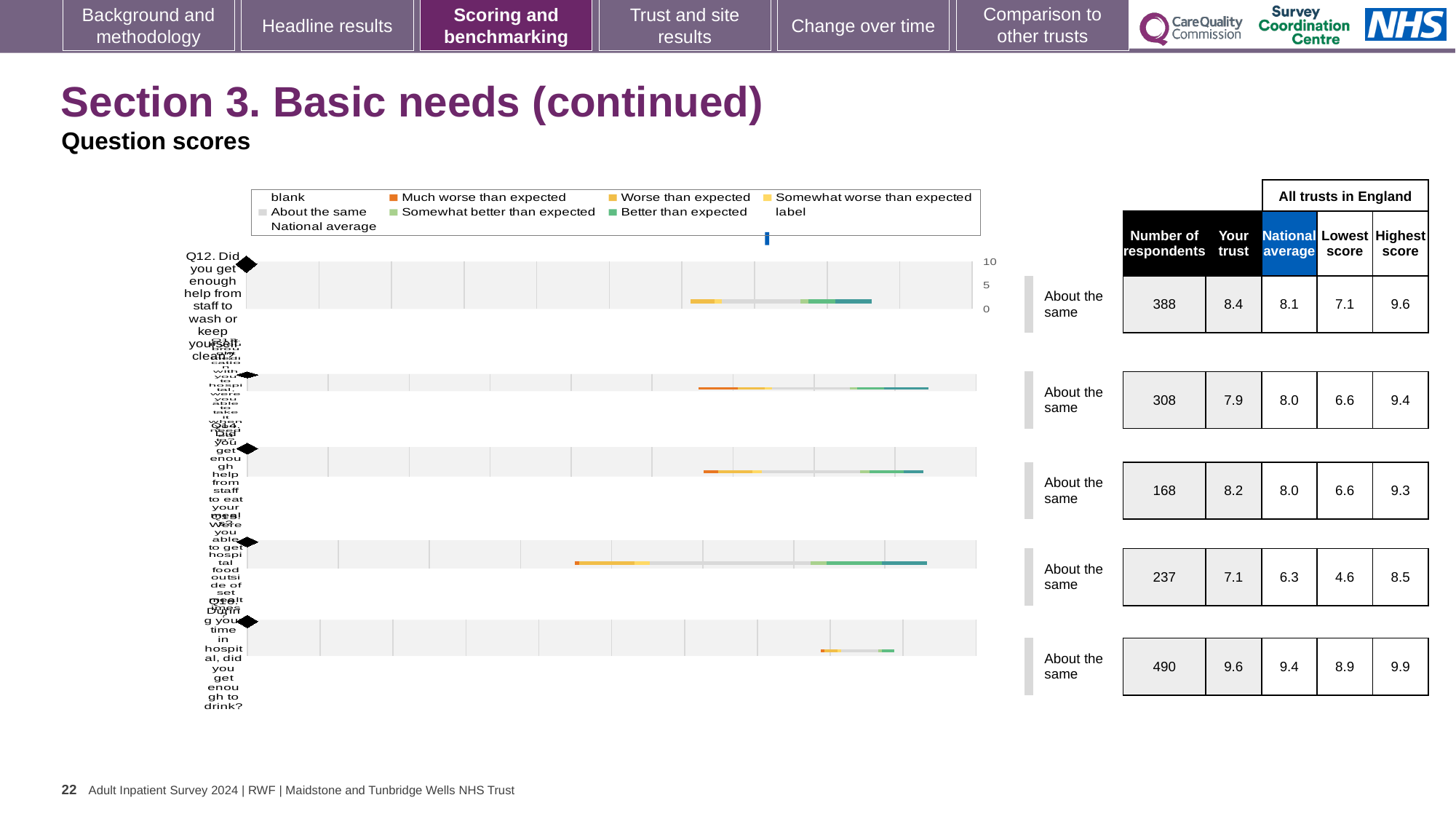
Which row has the lowest 'Your trust' score in the table? The fourth row, 7.1 In the table, what is the 'Your trust' score for the last row (Q16, about getting enough to drink)? 9.6 Which row has the highest 'Your trust' score in the table? Q16 (the last row), 9.6 For Q12 (the first row), what is the difference between the 'Your trust' score and the national average? 0.3 In the table, what is the number of respondents for Q12 (the first row, about getting enough help to wash or keep yourself clean)? 388 In the table, what is the national average for the second row? 8.0 What benchmark category is shown next to each of the five question rows? About the same In the table, what is the lowest score for the fourth row? 4.6 For the fourth row, which is larger: the 'Your trust' score or the national average? Your trust (7.1) In the table, what is the highest score for the third row (Q14, about getting enough help to eat your meals)? 9.3 How many question rows (charts) are shown on the slide? 5 What kind of chart is used to show the question scores on this slide? bar chart